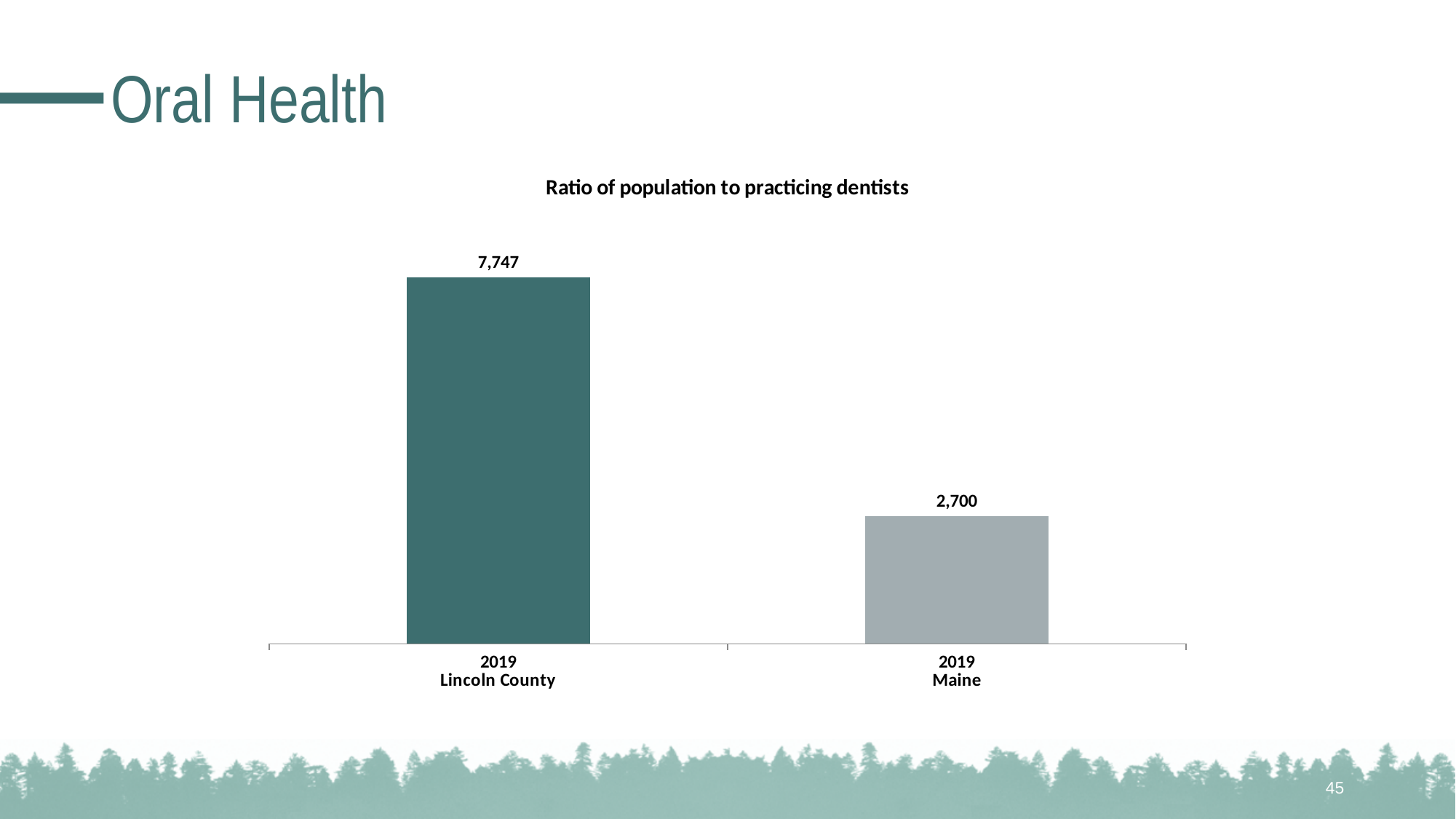
What is the ratio of population to practicing dentists for Maine in 2019? 2,700 What is the ratio of population to practicing dentists for Lincoln County in 2019? 7,747 What kind of chart is shown on the slide? bar chart Which category has the higher ratio of population to practicing dentists? Lincoln County How many bars are shown in the chart? 2 What is the difference between the Lincoln County and Maine ratios of population to practicing dentists? 5,047 What is the title of the chart? Ratio of population to practicing dentists What year do both bars in the chart refer to? 2019 Is the ratio for Lincoln County larger or smaller than the ratio for Maine? larger Which category has the lower ratio of population to practicing dentists? Maine